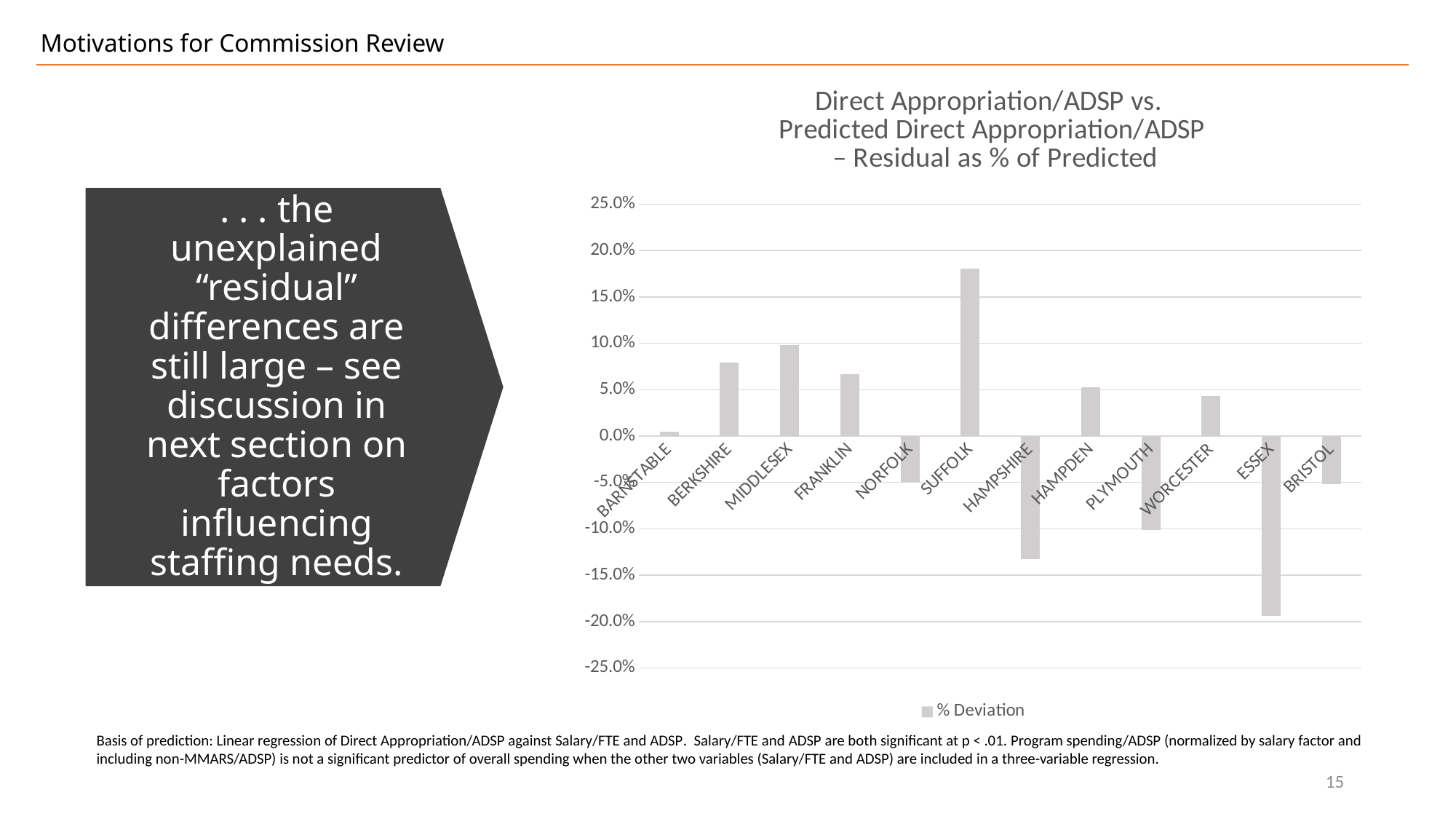
Is the % Deviation for Suffolk greater or less than 15.0%? greater Which county has the lowest % Deviation in the chart? Essex What is the name of the series shown in the chart's legend? % Deviation How many series does the chart's legend list? 1 Which has a larger % Deviation, Suffolk or Middlesex? Suffolk Is the % Deviation for Middlesex greater or less than 5.0%? greater Is the % Deviation for Hampshire greater or less than -10.0%? less How many counties are plotted on the x axis of the chart? 12 What kind of chart is shown on the slide? Bar chart Which county has the highest % Deviation in the chart? Suffolk Which has a larger % Deviation, Berkshire or Worcester? Berkshire